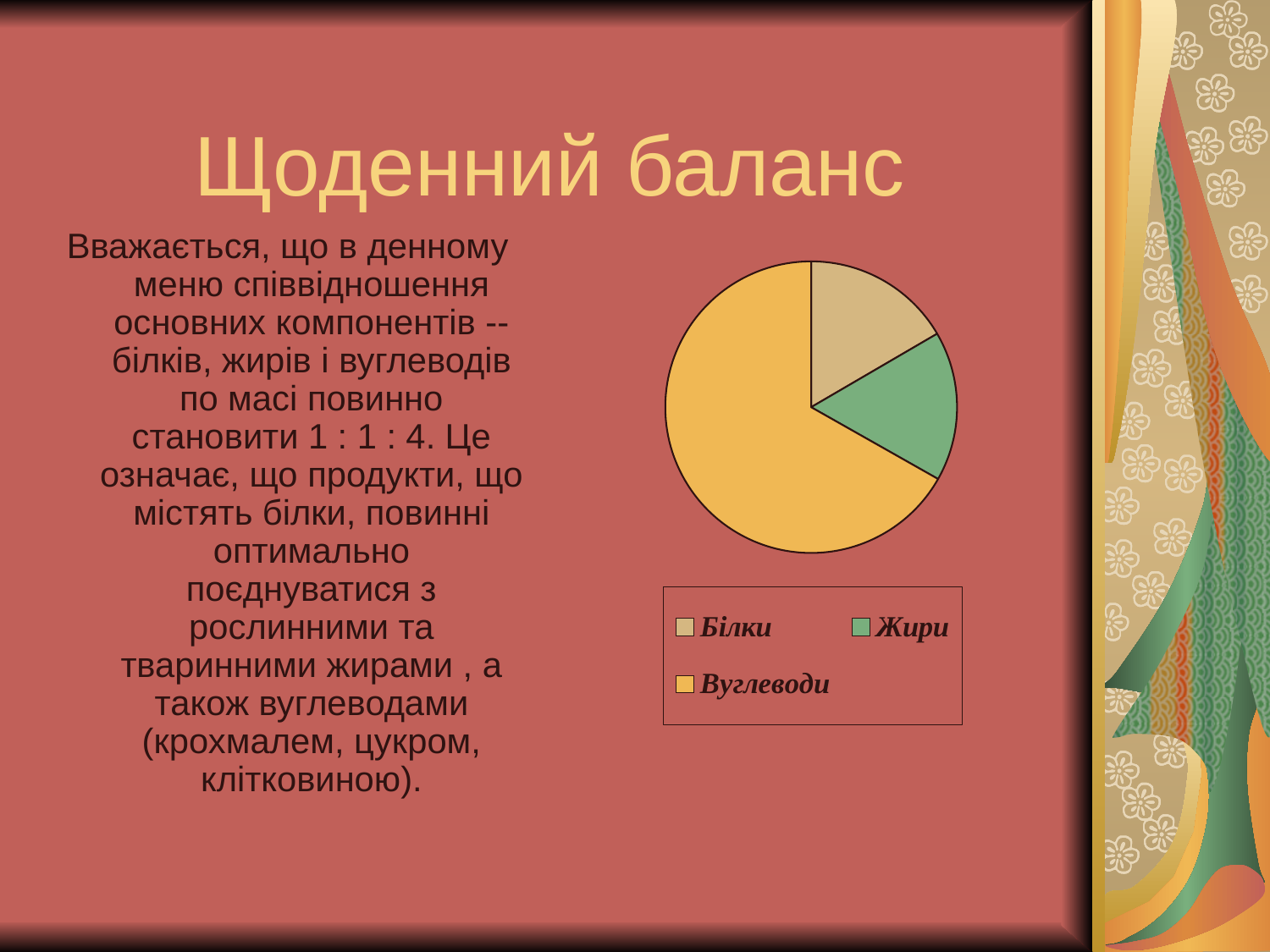
Which category has the largest slice in the pie chart? Вуглеводи What are the three categories listed in the legend of the pie chart? Білки, Жири, Вуглеводи What kind of chart is shown on the slide? pie chart How many slices does the pie chart have? 3 How many entries does the legend of the pie chart list? 3 What colour is the Жири slice in the pie chart? green Which slice is larger in the pie chart, Вуглеводи or Білки? Вуглеводи Does the Вуглеводи slice take up more or less than half of the pie chart? more Which slice is larger in the pie chart, Вуглеводи or Жири? Вуглеводи